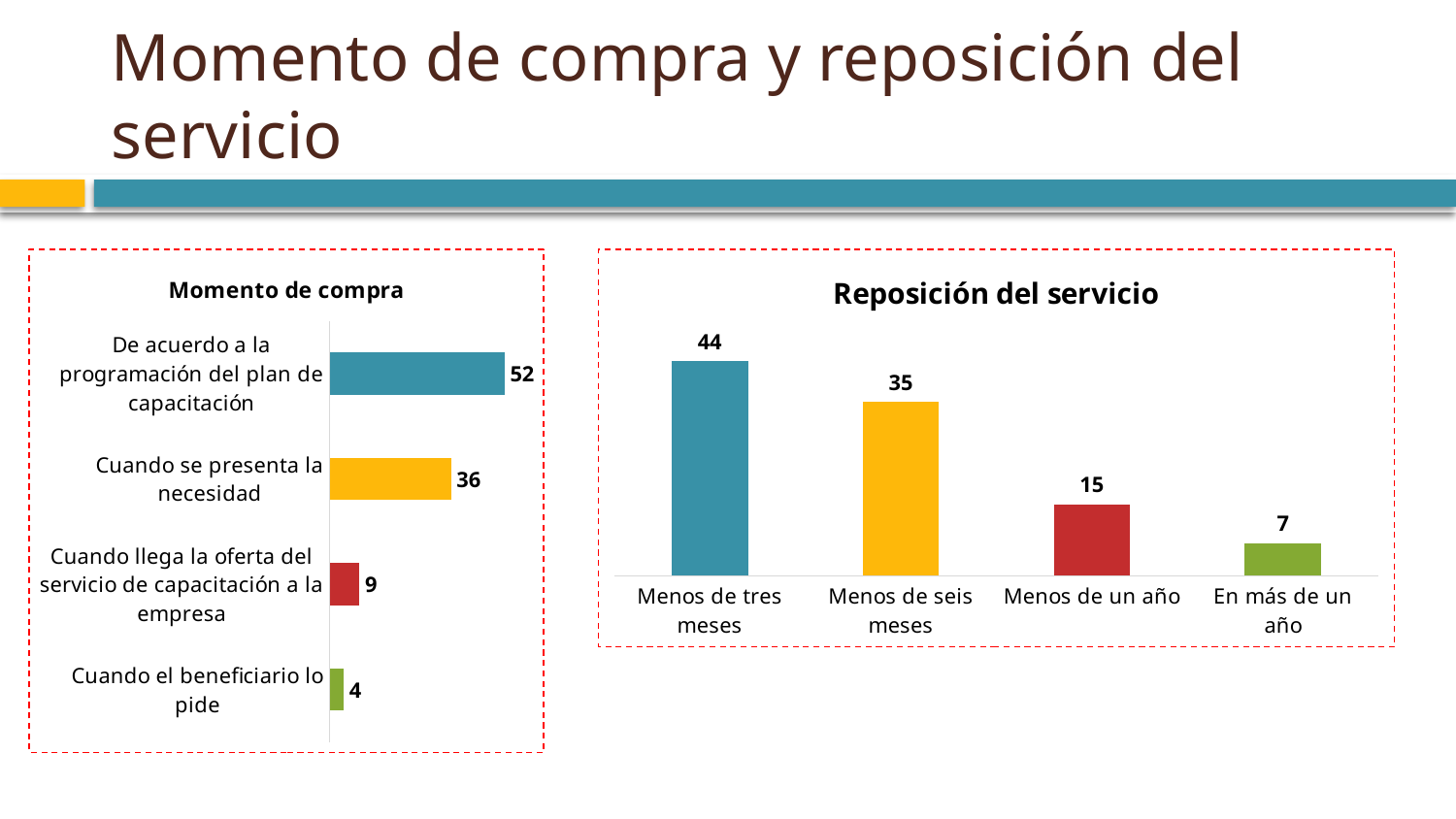
In the 'Momento de compra' chart, which category has the lowest value? Cuando el beneficiario lo pide In the 'Momento de compra' chart, which category has the highest value? De acuerdo a la programación del plan de capacitación In the 'Reposición del servicio' chart, which category has the lowest value? En más de un año In the 'Reposición del servicio' chart, what is the difference between 'Menos de tres meses' and 'Menos de seis meses'? 9 In the 'Reposición del servicio' chart, do the values rise or fall from left to right along the x axis? Fall In the 'Reposición del servicio' chart, what is the value for 'Menos de un año'? 15 What type of chart is the 'Momento de compra' chart? Bar chart In the 'Momento de compra' chart, what is the value for 'Cuando se presenta la necesidad'? 36 In the 'Reposición del servicio' chart, which category has the highest value? Menos de tres meses In the 'Momento de compra' chart, how many categories are shown? 4 In the 'Reposición del servicio' chart, which is larger: 'Menos de un año' or 'En más de un año'? Menos de un año In the 'Momento de compra' chart, what is the difference between 'De acuerdo a la programación del plan de capacitación' and 'Cuando se presenta la necesidad'? 16